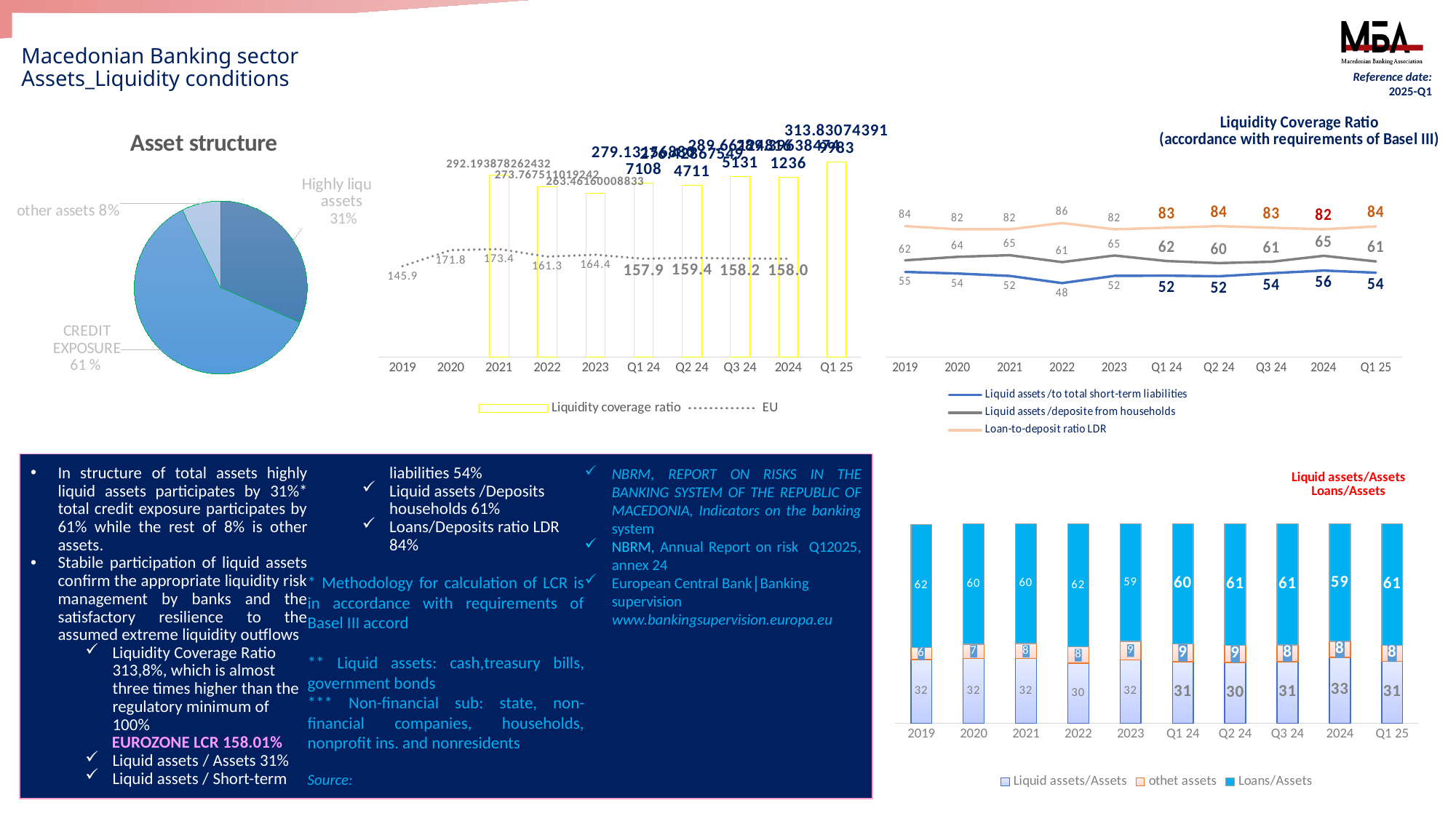
In the Liquidity Coverage Ratio (accordance with requirements of Basel III) line chart, what is the Loan-to-deposit ratio LDR for Q1 25? 84 In the bottom-right stacked bar chart, what is the Loans/Assets value for Q1 25? 61 In the Asset structure pie chart, what share is CREDIT EXPOSURE? 61% In the Asset structure pie chart, how many slices are there? 3 In the Asset structure pie chart, what share is other assets? 8% In the middle chart with the Liquidity coverage ratio bars, what is the EU value for 2024? 158.0 In the Liquidity Coverage Ratio (accordance with requirements of Basel III) line chart, how many series does the legend list? 3 In the Liquidity Coverage Ratio (accordance with requirements of Basel III) line chart, what is the difference between Liquid assets /deposite from households and Liquid assets /to total short-term liabilities in 2024? 9 In the Liquidity Coverage Ratio (accordance with requirements of Basel III) line chart, what is the value of Liquid assets /to total short-term liabilities for 2022? 48 In the middle chart with the Liquidity coverage ratio bars, what is the EU value for 2019? 145.9 In the middle chart with the Liquidity coverage ratio bars, which year has the highest EU value? 2021 In the bottom-right stacked bar chart, what is the Liquid assets/Assets value for 2024? 33